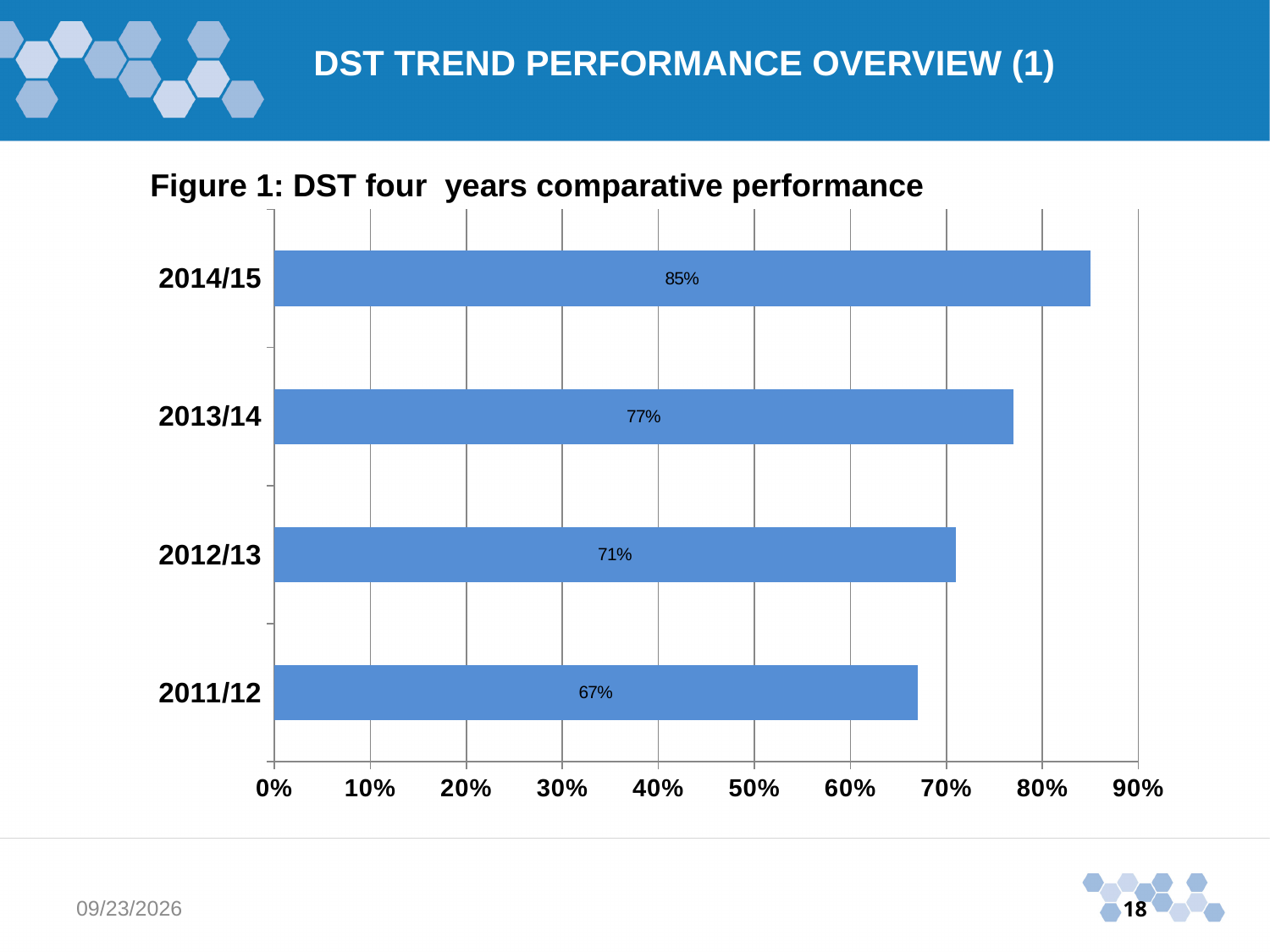
Which is larger, the value for 2013/14 or the value for 2012/13? 2013/14 What is the title of the figure on the slide? Figure 1: DST four years comparative performance Is the value for 2013/14 greater or less than 70%? greater Which year has the lowest value? 2011/12 What is the value for 2014/15? 85% What is the difference between the values for 2014/15 and 2013/14? 8% What kind of chart is shown on the slide? bar chart How many years are shown in the chart? 4 What is the value for 2012/13? 71% Which year has the highest value? 2014/15 What is the value for 2011/12? 67% What is the difference between the values for 2012/13 and 2011/12? 4%